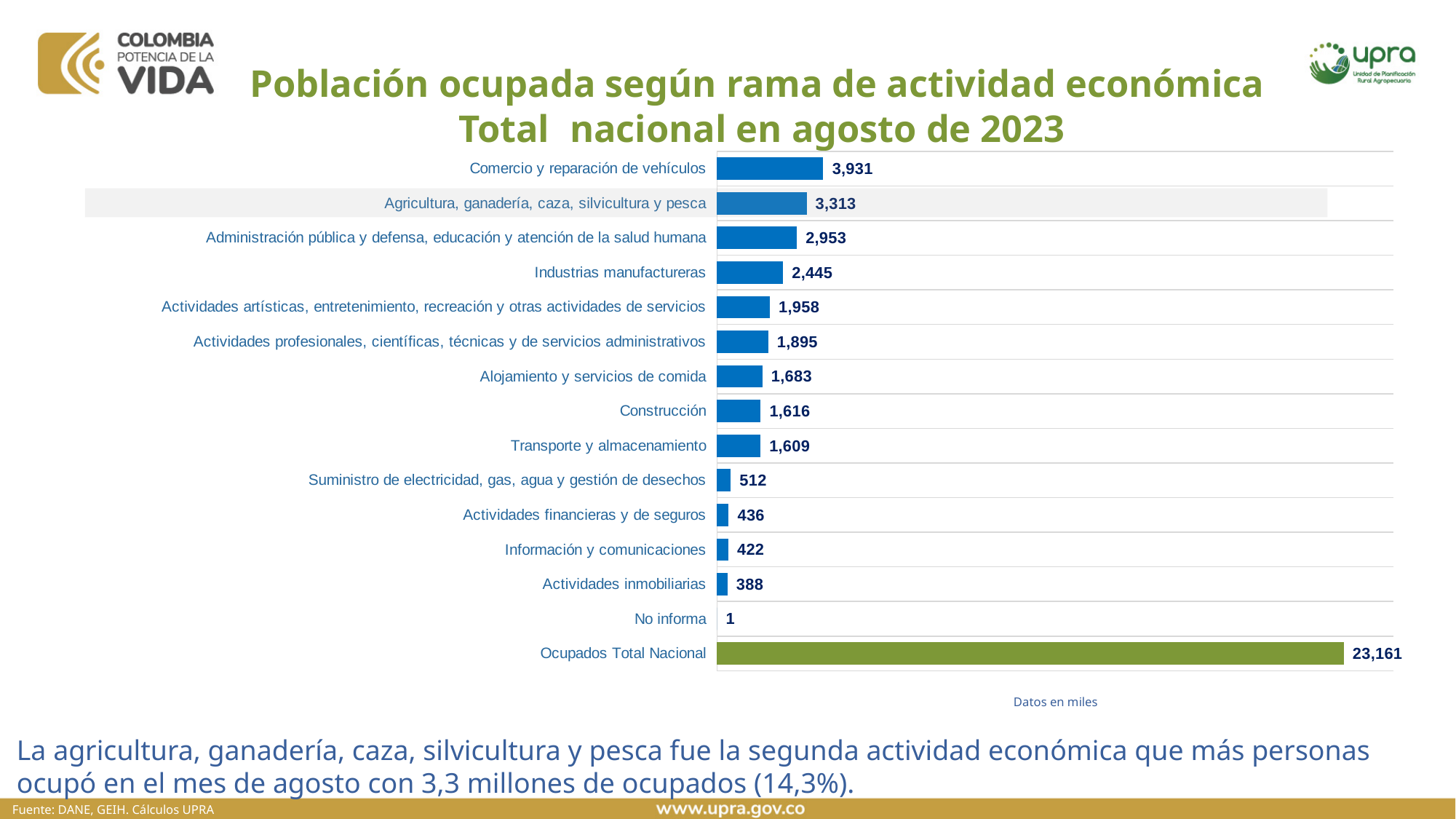
What is the value for Ocupados Total Nacional? 23,161 What is the value for Industrias manufactureras? 2,445 Which category has the lowest value? No informa What is the difference between Comercio y reparación de vehículos and Agricultura, ganadería, caza, silvicultura y pesca? 618 Which is larger, Construcción or Transporte y almacenamiento? Construcción What is the difference between Actividades financieras y de seguros and Información y comunicaciones? 14 What is the value for Comercio y reparación de vehículos? 3,931 How many categories are shown in the chart? 15 What is the value for Agricultura, ganadería, caza, silvicultura y pesca? 3,313 Which economic activity (excluding the national total) has the highest value? Comercio y reparación de vehículos What unit note is shown below the chart? Datos en miles What kind of chart is shown on the slide? Bar chart